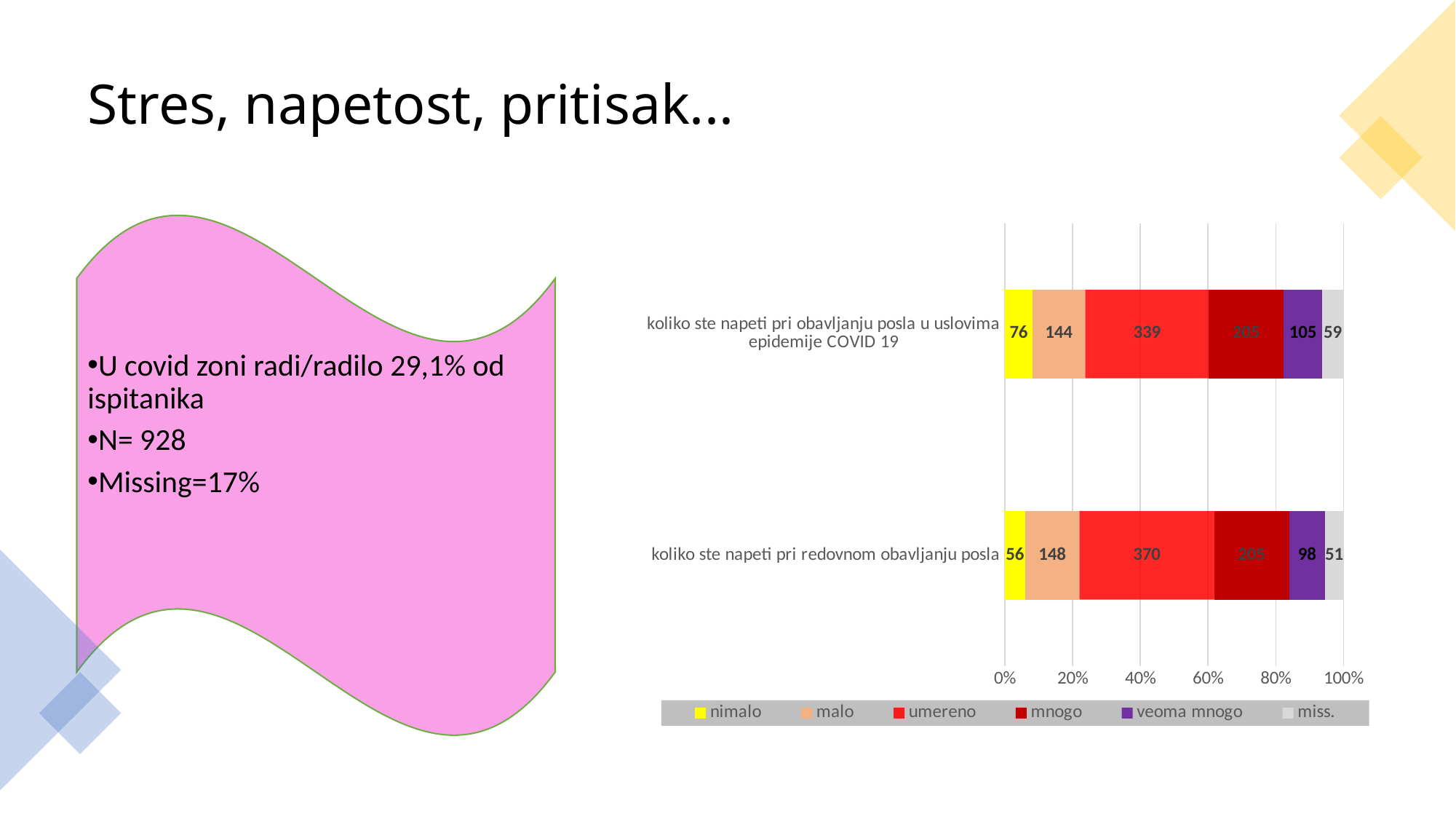
What is the value of 'miss.' for 'koliko ste napeti pri obavljanju posla u uslovima epidemije COVID 19'? 59 What is the value of 'umereno' for 'koliko ste napeti pri obavljanju posla u uslovima epidemije COVID 19'? 339 What is the difference between the 'umereno' values of the two bars? 31 How many categories (bars) does the chart show? 2 What kind of chart is shown on the slide? stacked bar chart What is the value of 'nimalo' for 'koliko ste napeti pri obavljanju posla u uslovima epidemije COVID 19'? 76 Which series has the largest value in the 'koliko ste napeti pri redovnom obavljanju posla' bar? umereno What is the value of 'umereno' for 'koliko ste napeti pri redovnom obavljanju posla'? 370 How many series does the chart legend list? 6 Which colour represents the 'veoma mnogo' series in the legend? purple Which bar has the larger 'nimalo' value? koliko ste napeti pri obavljanju posla u uslovima epidemije COVID 19 What is the value of 'veoma mnogo' for 'koliko ste napeti pri redovnom obavljanju posla'? 98